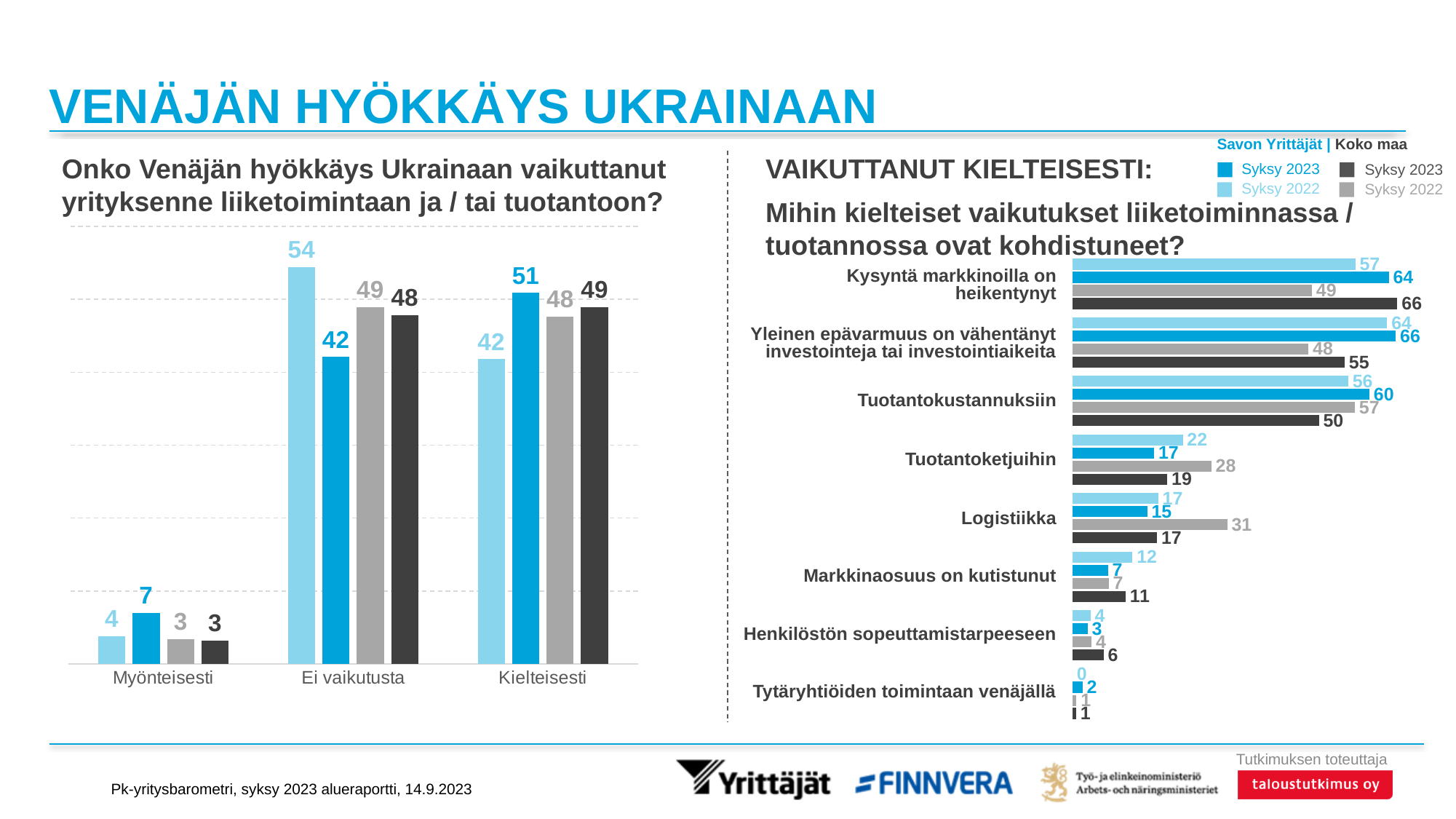
In the left chart, what is the Savon Yrittäjät Syksy 2022 value for Ei vaikutusta? 54 In the right chart, which is larger for Tuotantokustannuksiin: the Savon Yrittäjät Syksy 2023 value or the Koko maa Syksy 2023 value? Savon Yrittäjät Syksy 2023 In the left chart, what is the Savon Yrittäjät Syksy 2023 value for Kielteisesti? 51 In the left chart, how many categories are shown on the x axis? 3 In the left chart, which category has the lowest values across all series? Myönteisesti In the right chart, how many categories are listed? 8 In the left chart, what is the difference between the Savon Yrittäjät Syksy 2022 and Syksy 2023 values for Ei vaikutusta? 12 In the right chart, what is the Koko maa Syksy 2022 value for Logistiikka? 31 In the right chart, which category has the lowest values? Tytäryhtiöiden toimintaan venäjällä How many series does the legend list? 4 What type of chart is the left chart? Bar chart In the right chart, what is the Koko maa Syksy 2023 value for Kysyntä markkinoilla on heikentynyt? 66